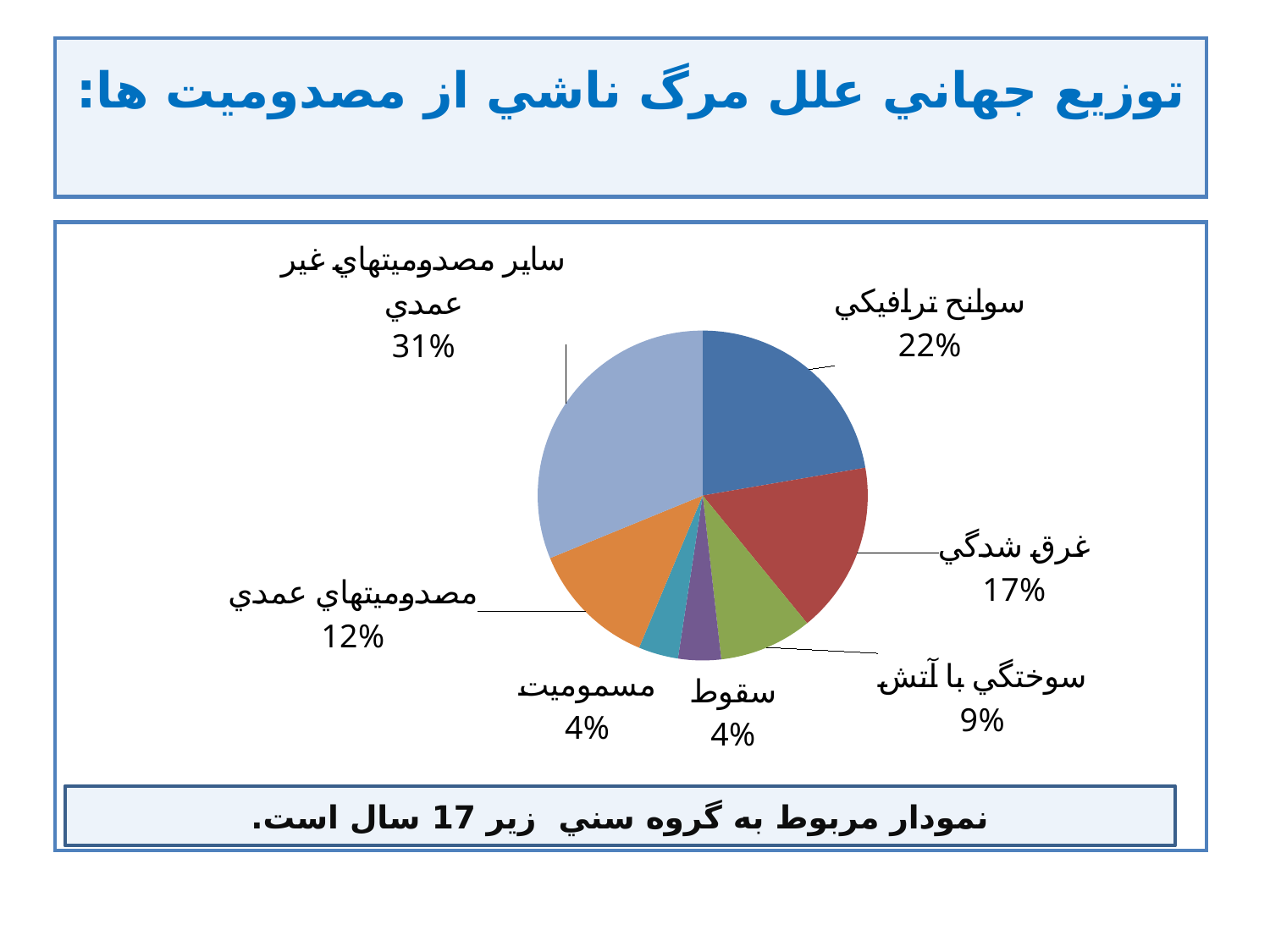
Which categories share the smallest value in the pie chart? سقوط and مسموميت (4% each) According to the note below the chart, which age group does the chart refer to? under 17 years What is the difference between the shares of سوانح ترافيكي and غرق شدگي? 5% What percentage is shown for غرق شدگي (drowning)? 17% How many slices does the pie chart have? 7 What is the combined share of سقوط and مسموميت? 8% Which category has the largest share of the pie? ساير مصدوميتهاي غير عمدي (31%) What percentage is shown for سوختگي با آتش (burns from fire)? 9% What type of chart is shown on the slide? pie chart Which is larger, the share for مصدوميتهاي عمدي or the share for سوختگي با آتش? مصدوميتهاي عمدي What percentage is shown for سوانح ترافيكي (traffic accidents)? 22% What percentage is shown for مصدوميتهاي عمدي (intentional injuries)? 12%